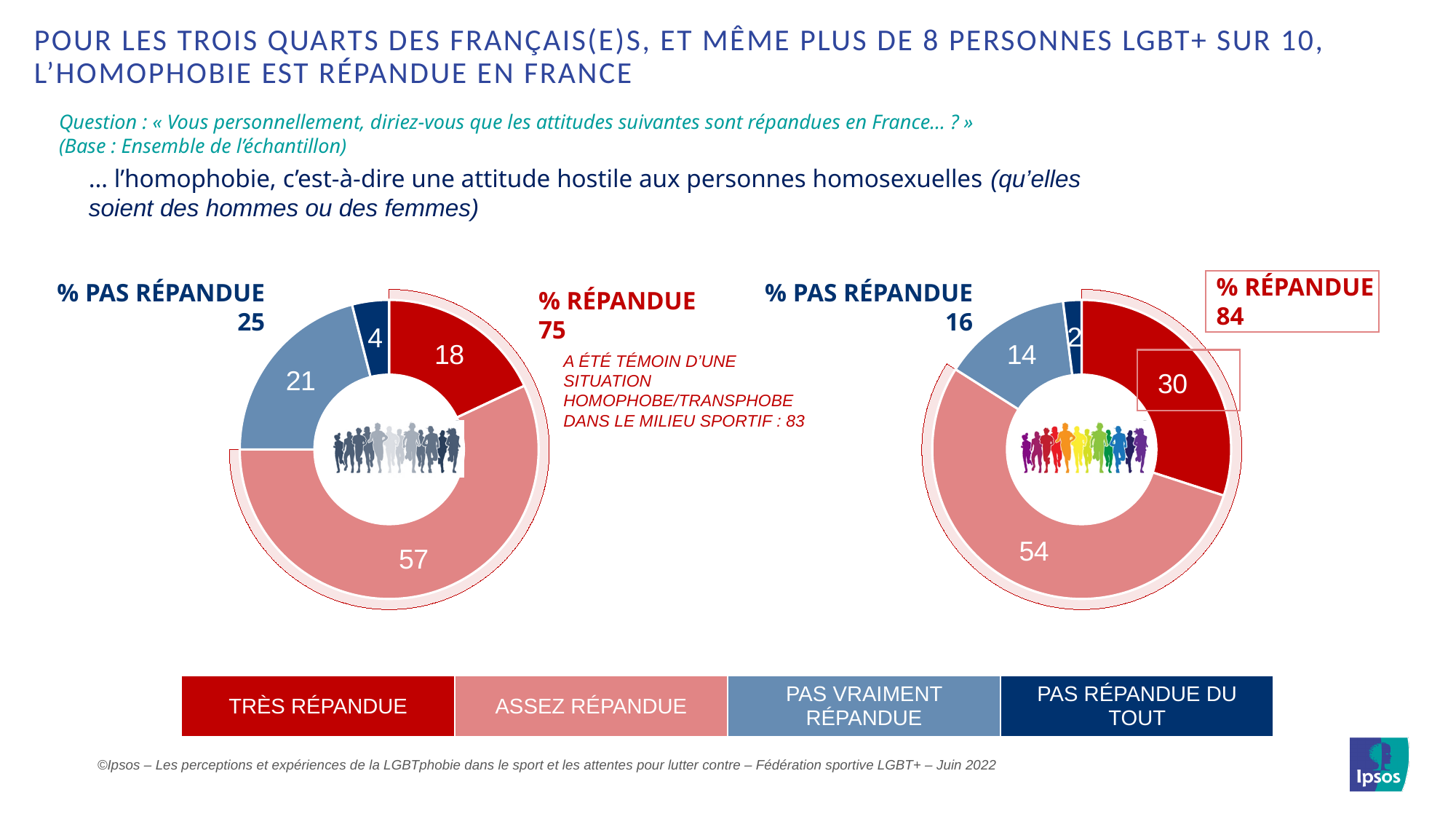
In the left donut chart, what is the difference between "Assez répandue" and "Pas vraiment répandue"? 36 What is the difference between the "Très répandue" values in the right donut chart and the left donut chart? 12 In the left donut chart, what is the value for "Pas répandue du tout"? 4 In the left donut chart, which category has the smallest value? Pas répandue du tout In the right donut chart, what is the value for "Pas vraiment répandue"? 14 In the right donut chart, what is the value for "Très répandue"? 30 Which is larger: "Pas vraiment répandue" in the left donut chart or "Pas vraiment répandue" in the right donut chart? Left donut chart How many categories does the legend at the bottom of the slide list? 4 What is the "% RÉPANDUE" total shown next to the right donut chart? 84 What type of chart is used on the left of the slide? Donut (pie) chart In the right donut chart, which category has the largest value? Assez répandue In the left donut chart, what is the value for "Assez répandue"? 57